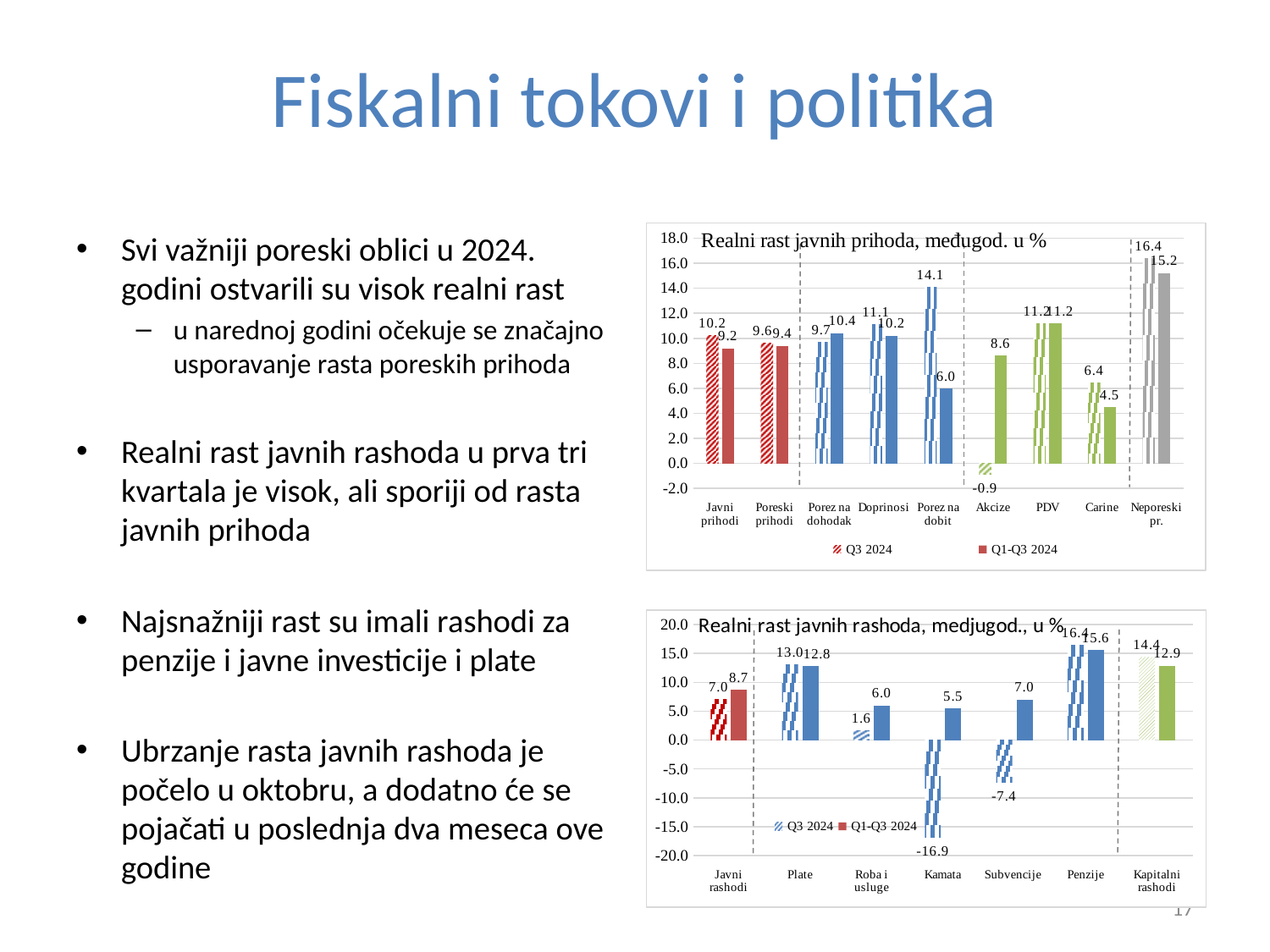
In the bottom chart (Realni rast javnih rashoda), what is the Q3 2024 value for Kamata? -16.9 In the bottom chart (Realni rast javnih rashoda), how many series does the legend list? 2 In the bottom chart (Realni rast javnih rashoda), which category has the highest Q3 2024 value? Penzije In the top chart (Realni rast javnih prihoda), how many categories are shown on the x axis? 9 In the bottom chart (Realni rast javnih rashoda), is the Q1-Q3 2024 value for Plate larger or the Q1-Q3 2024 value for Kapitalni rashodi? Kapitalni rashodi In the top chart (Realni rast javnih prihoda), which category has the lowest Q3 2024 value? Akcize In the top chart (Realni rast javnih prihoda), what is the difference between the Q3 2024 and Q1-Q3 2024 values for Porez na dobit? 8.1 In the top chart (Realni rast javnih prihoda), what is the Q1-Q3 2024 value for Akcize? 8.6 What kind of chart is the bottom chart (Realni rast javnih rashoda)? Bar chart In the bottom chart (Realni rast javnih rashoda), what is the Q1-Q3 2024 value for Penzije? 15.6 In the top chart (Realni rast javnih prihoda), which category has the highest Q1-Q3 2024 value? Neporeski pr. In the top chart (Realni rast javnih prihoda), what is the Q3 2024 value for Porez na dobit? 14.1